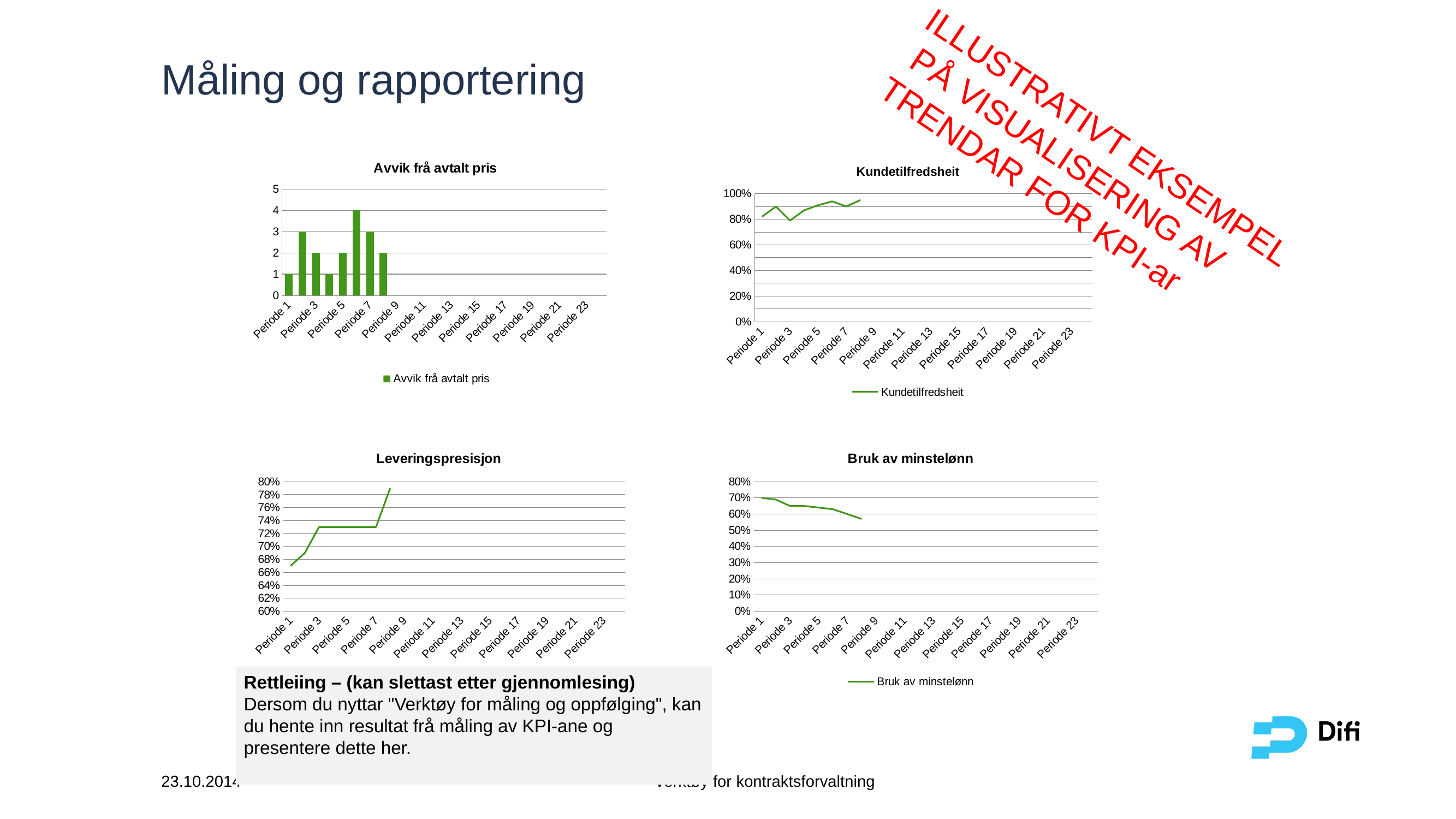
In the 'Kundetilfredsheit' chart, is the value for Periode 7 greater or less than 80%? greater In the 'Avvik frå avtalt pris' chart, what is the value for Periode 1? 1 In the 'Bruk av minstelønn' chart, what is the value for Periode 1? 70% In the 'Avvik frå avtalt pris' chart, which is larger, the value for Periode 7 or the value for Periode 1? Periode 7 In the 'Leveringspresisjon' chart, is the value for Periode 1 greater or less than 70%? less What kind of chart is 'Kundetilfredsheit'? Line chart In the 'Leveringspresisjon' chart, do the plotted values generally rise or fall from Periode 1 onward? Rise What kind of chart is 'Avvik frå avtalt pris'? Bar chart In the 'Avvik frå avtalt pris' chart, what is the value for Periode 7? 3 In the 'Bruk av minstelønn' chart, do the plotted values rise or fall from Periode 1 onward? Fall How many series does the legend of the 'Bruk av minstelønn' chart list? 1 In the 'Avvik frå avtalt pris' chart, what is the difference between the values for Periode 7 and Periode 1? 2